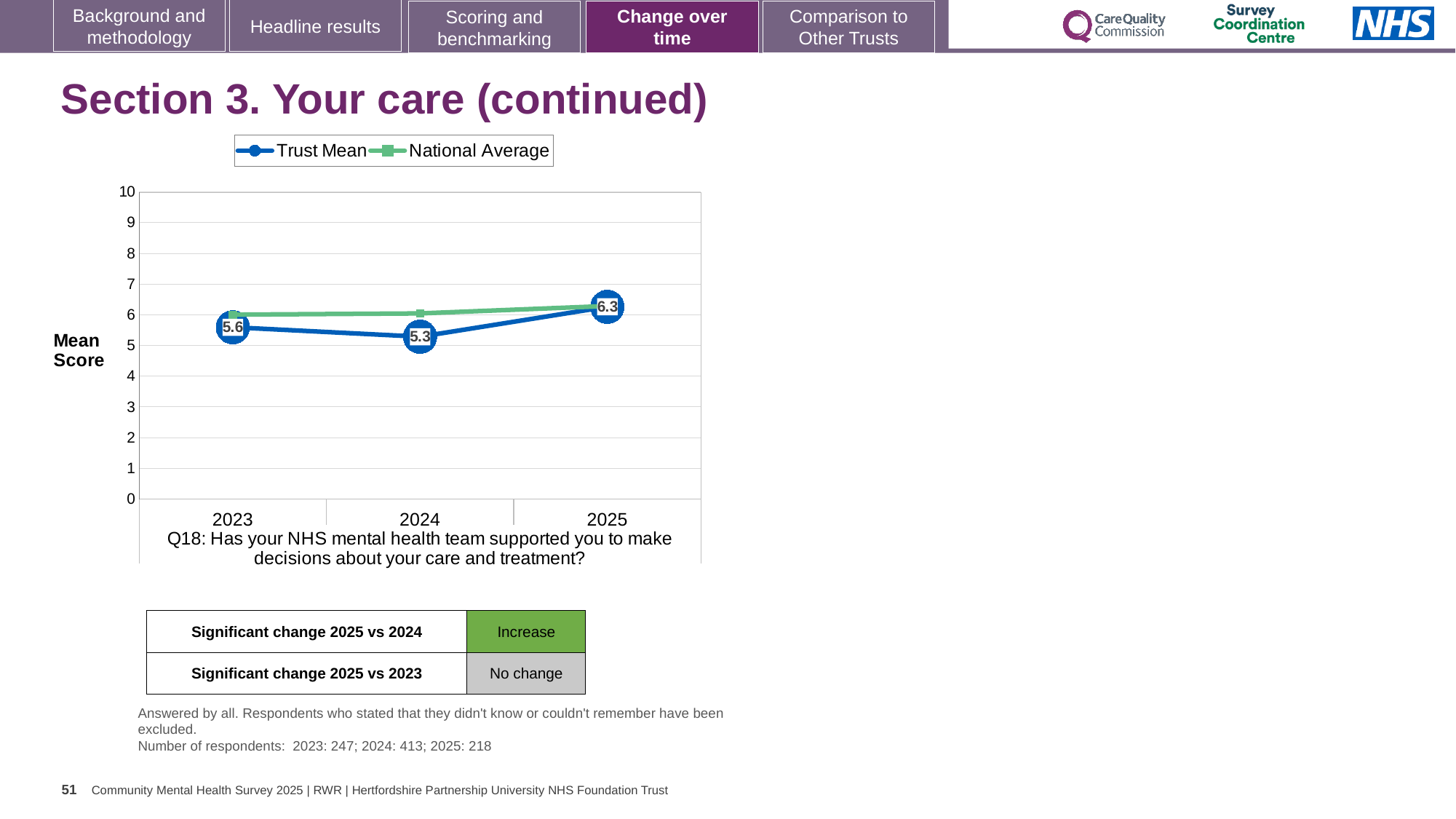
What is the difference between the Trust Mean score in 2025 and in 2024? 1.0 What is the Trust Mean score for 2025? 6.3 Which is larger in 2024, the Trust Mean or the National Average? National Average How many series does the chart legend list? 2 In which year is the Trust Mean score lowest? 2024 Is the National Average value for 2025 greater or less than 7? less Is the National Average value for 2024 greater or less than 5? greater What is the Trust Mean score for 2024? 5.3 What is the Trust Mean score for 2023? 5.6 How many years are shown on the x axis of the chart? 3 What kind of chart is shown on the slide? Line chart In which year is the Trust Mean score highest? 2025